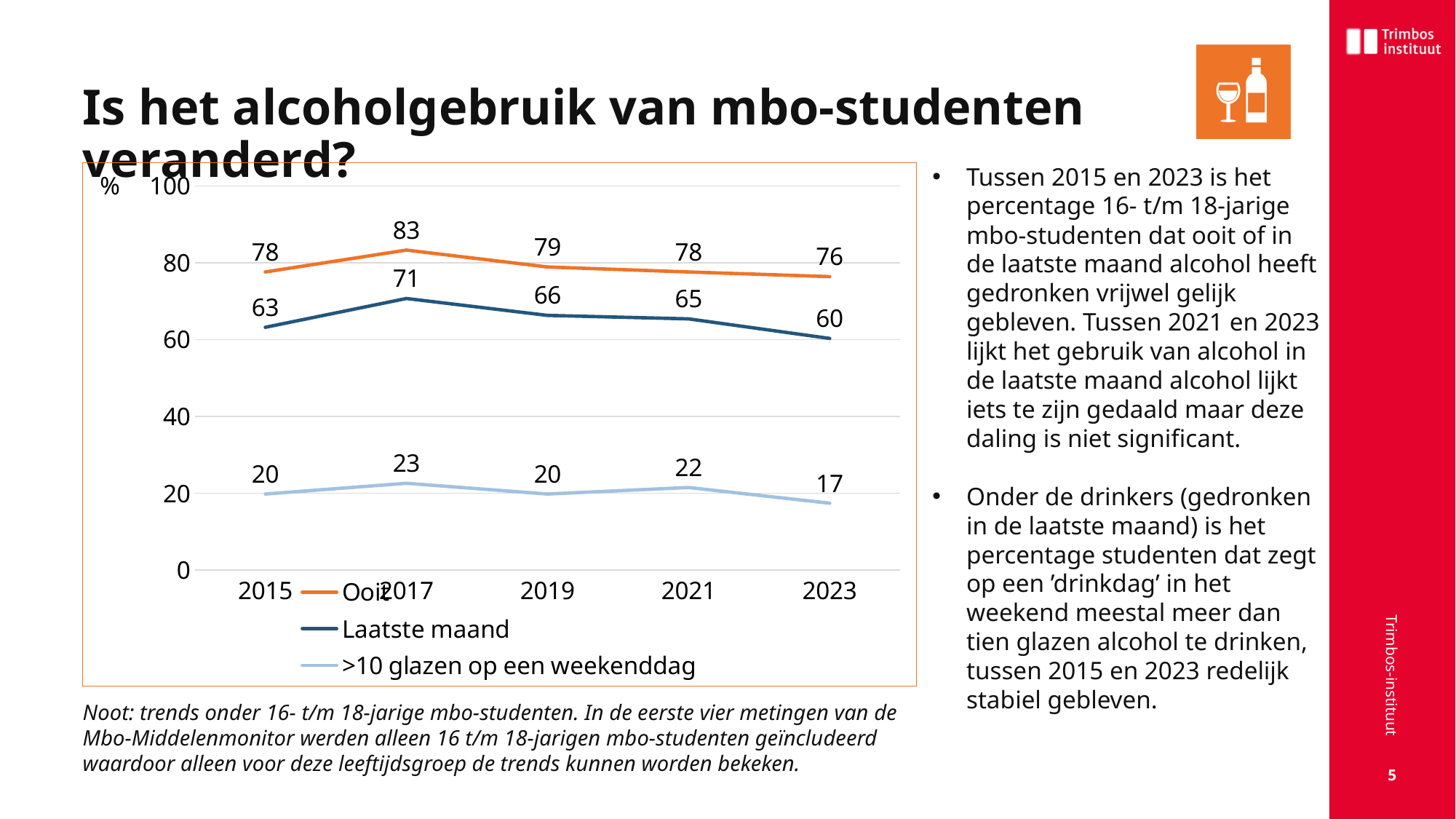
What type of chart is shown on the slide? line chart How many years are plotted along the x axis? 5 How many series does the legend list? 3 Does the 'Ooit' series rise or fall between 2017 and 2023? fall What is the value for 'Ooit' in 2017? 83 In which year is the '>10 glazen op een weekenddag' series lowest? 2023 Which series is drawn in orange? Ooit In which year is the 'Laatste maand' series highest? 2017 Which is larger: the 'Laatste maand' value in 2019 or in 2021? 2019 What is the value for '>10 glazen op een weekenddag' in 2021? 22 What is the value for 'Laatste maand' in 2023? 60 What is the difference between the 'Ooit' value and the 'Laatste maand' value in 2015? 15